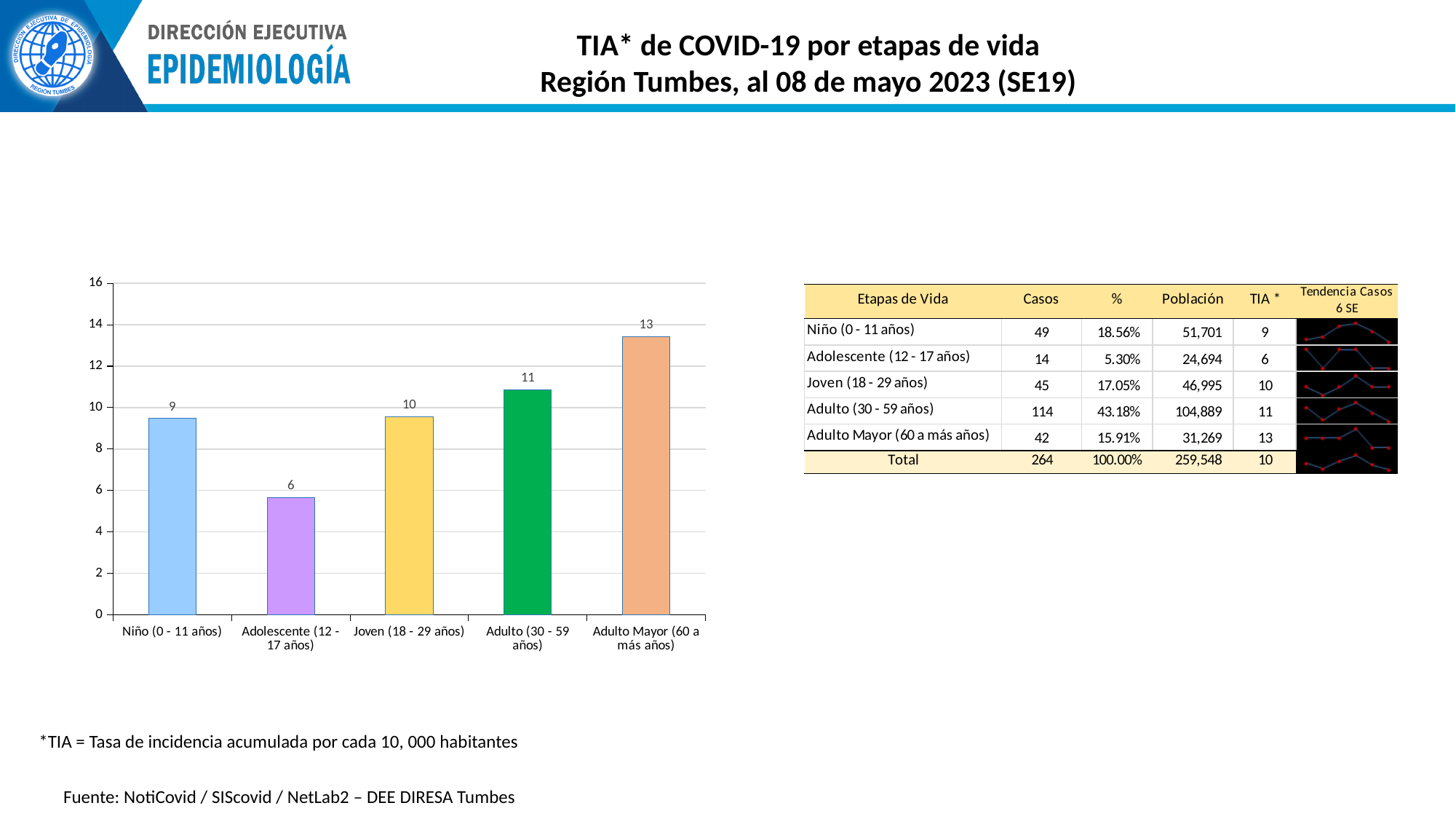
Which age group has the highest bar in the chart? Adulto Mayor (60 a más años) What kind of chart is shown on the slide? bar chart Which is larger in the bar chart: the value for Adulto (30 - 59 años) or for Adolescente (12 - 17 años)? Adulto (30 - 59 años) Which age group has the lowest bar in the chart? Adolescente (12 - 17 años) Is the bar for Adolescente (12 - 17 años) greater or less than 8? less How many age-group categories are plotted in the bar chart? 5 What is the TIA value shown for Adolescente (12 - 17 años) in the bar chart? 6 Is the bar for Adulto Mayor (60 a más años) greater or less than 12? greater What is the TIA value shown for Adulto (30 - 59 años) in the bar chart? 11 What is the difference between the labelled values for Adulto Mayor (60 a más años) and Adolescente (12 - 17 años)? 7 What is the maximum value shown on the vertical axis of the bar chart? 16 What is the TIA value shown for Adulto Mayor (60 a más años) in the bar chart? 13